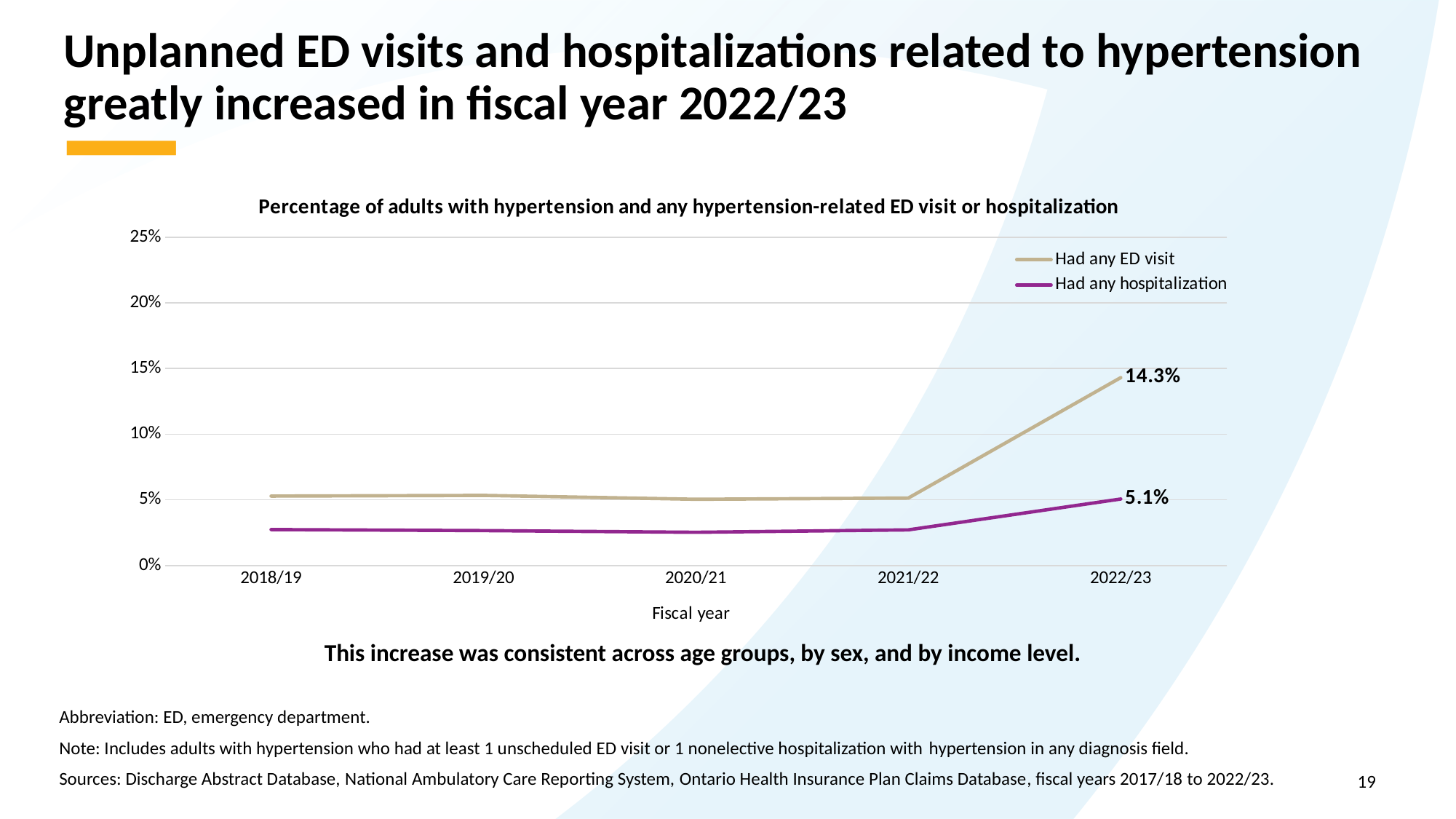
Is the value for 'Had any ED visit' in 2018/19 greater or less than 10%? less What is the difference between the 'Had any ED visit' and 'Had any hospitalization' values in 2022/23? 9.2% What is the title of the chart? Percentage of adults with hypertension and any hypertension-related ED visit or hospitalization What type of chart is shown on the slide? line chart What is the value for 'Had any hospitalization' in 2022/23? 5.1% Does the 'Had any ED visit' line rise or fall between 2021/22 and 2022/23? rise What is the value for 'Had any ED visit' in 2022/23? 14.3% How many fiscal years are shown on the x axis? 5 How many series does the legend list? 2 Which series has the higher value in 2022/23, 'Had any ED visit' or 'Had any hospitalization'? Had any ED visit Is the value for 'Had any hospitalization' in 2021/22 greater or less than 5%? less In which fiscal year is the 'Had any ED visit' value highest? 2022/23